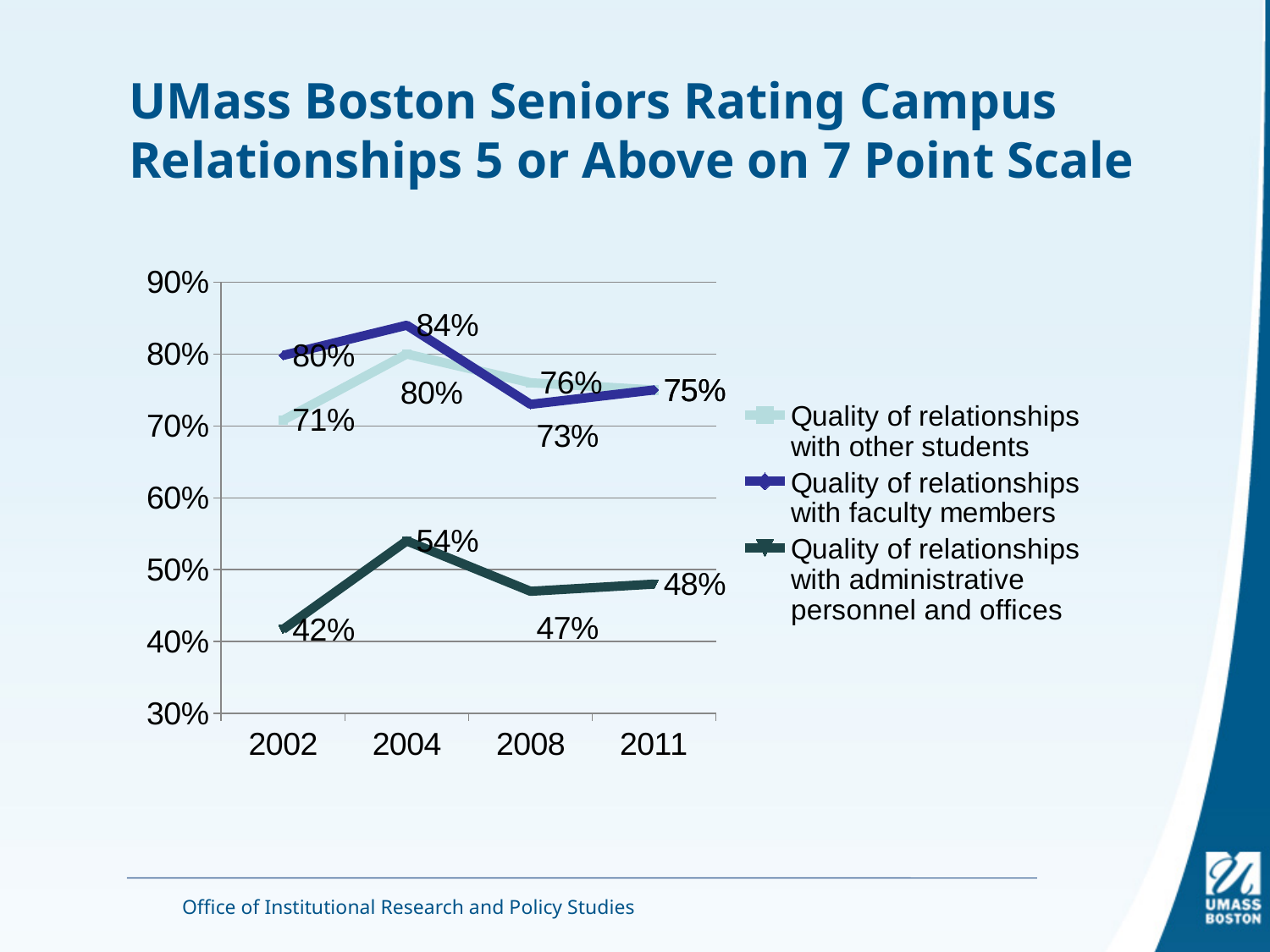
By how many percentage points did the rating for relationships with faculty members fall from 2004 to 2008? 11 percentage points What is the value for quality of relationships with other students in 2002? 71% Is the value for quality of relationships with other students in 2011 greater or less than 70%? greater What is the value for quality of relationships with administrative personnel and offices in 2008? 47% In which year was the rating for relationships with administrative personnel and offices lowest? 2002 What percentage of seniors rated the quality of relationships with faculty members 5 or above in 2004? 84% What kind of chart is shown on the slide? Line chart In 2008, which was rated higher: relationships with other students or relationships with faculty members? Relationships with other students How many years are shown on the x axis? 4 How many series does the legend list? 3 In which year was the rating for relationships with administrative personnel and offices highest? 2004 What is the value for quality of relationships with administrative personnel and offices in 2011? 48%